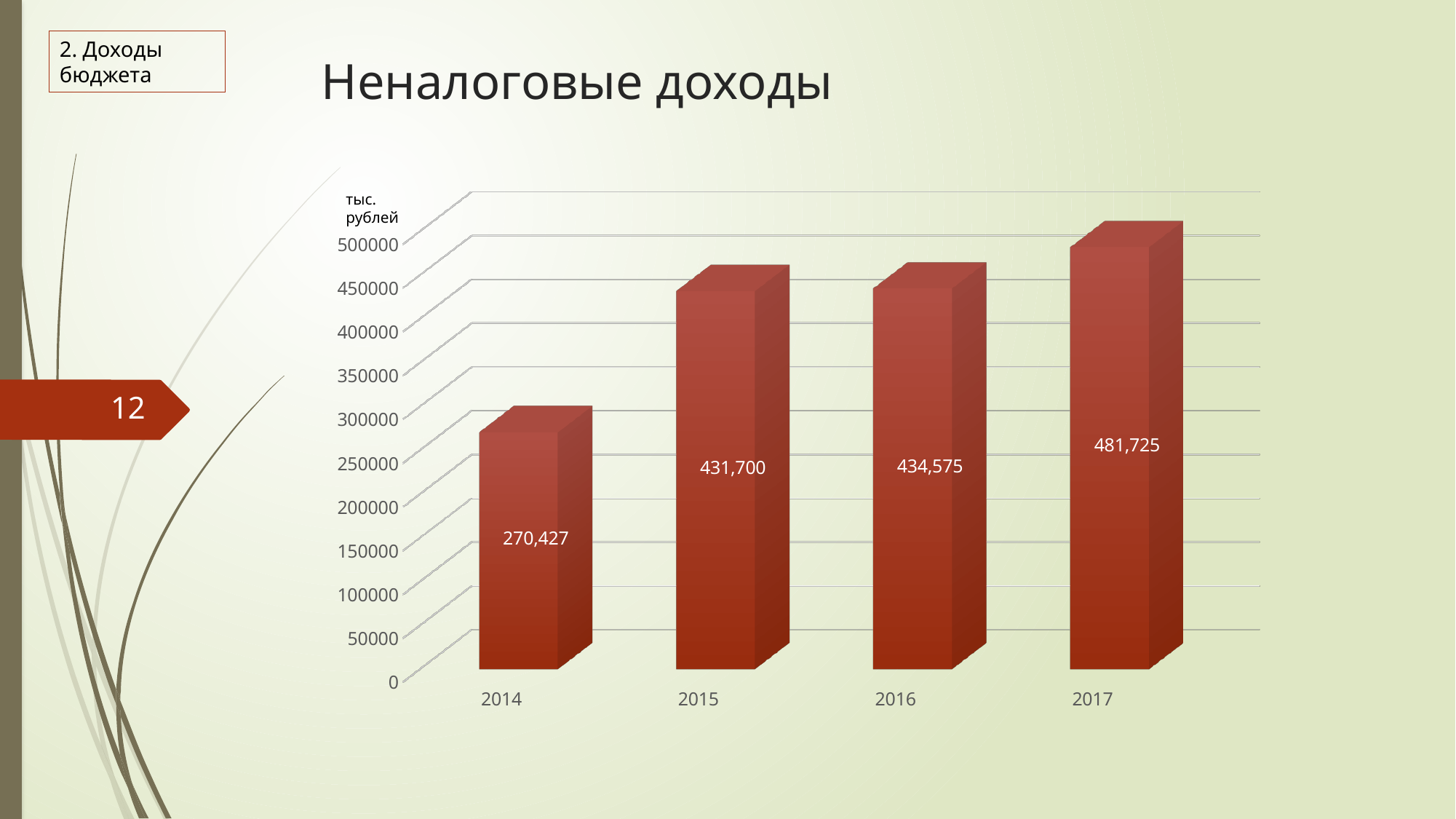
What is the value for 2014? 270,427 What is the difference between the values for 2017 and 2014? 211,298 Which is larger, the value for 2014 or the value for 2017? 2017 What is the title of the chart? Неналоговые доходы Which year has the lowest value? 2014 What is the value for 2017? 481,725 What kind of chart is shown? bar chart How many years are shown on the x axis? 4 What is the value for 2015? 431,700 Which year has the highest value? 2017 What is the difference between the values for 2016 and 2015? 2,875 Is the value for 2014 greater or less than 300000? less